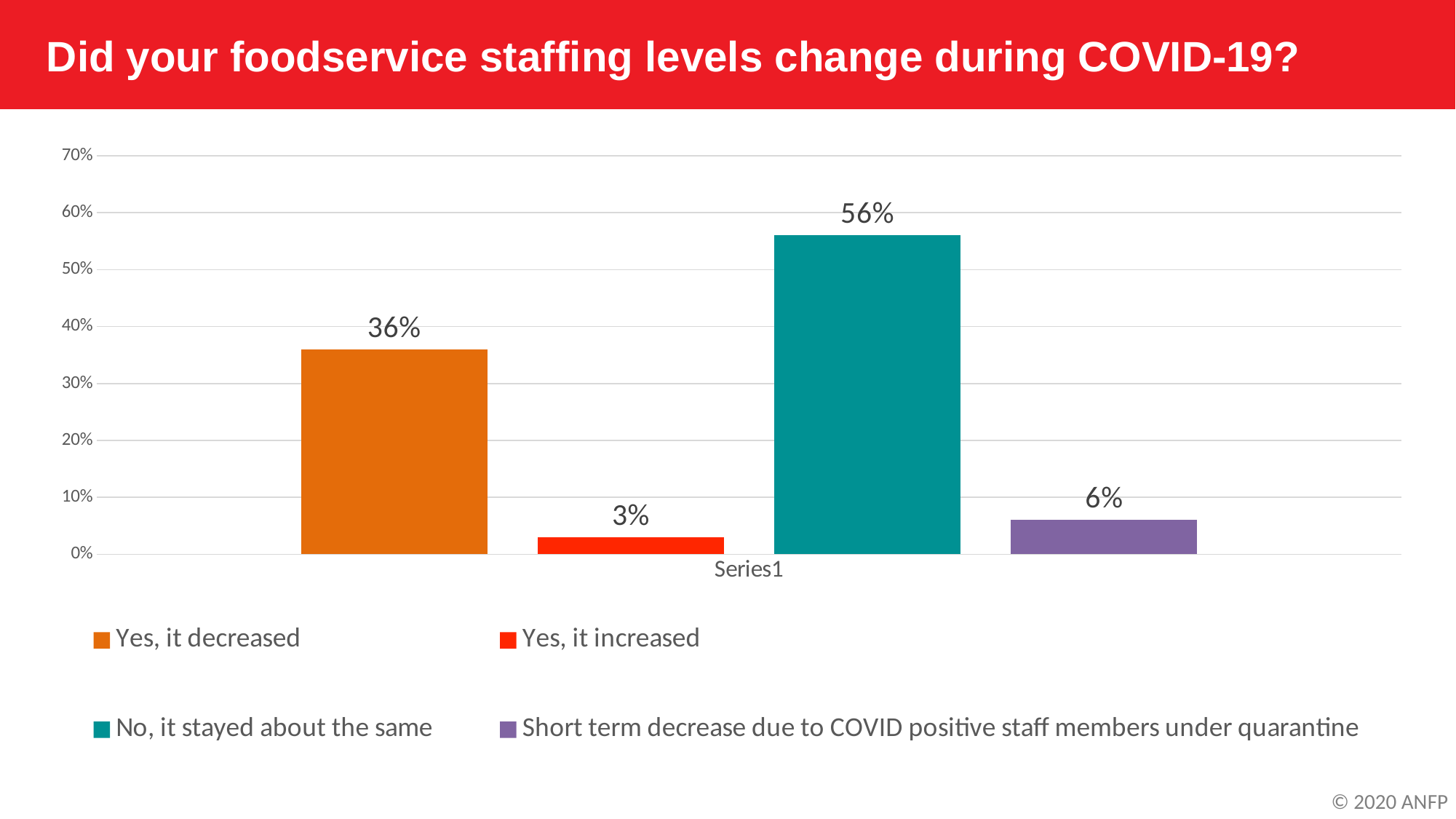
Which response has the highest percentage? No, it stayed about the same Which response has the lowest percentage? Yes, it increased Is the value for 'No, it stayed about the same' greater or less than 50%? greater What percentage of respondents said staffing levels stayed about the same? 56% What percentage of respondents said their foodservice staffing levels increased? 3% How many response categories are shown in the legend? 4 What percentage of respondents reported a short term decrease due to COVID positive staff members under quarantine? 6% What is the difference in percentage points between 'No, it stayed about the same' and 'Yes, it decreased'? 20 Which is larger: the percentage for 'Yes, it decreased' or for 'Short term decrease due to COVID positive staff members under quarantine'? Yes, it decreased What colour is the bar for 'No, it stayed about the same'? Teal What percentage of respondents said their foodservice staffing levels decreased during COVID-19? 36% What type of chart is shown on the slide? Bar chart